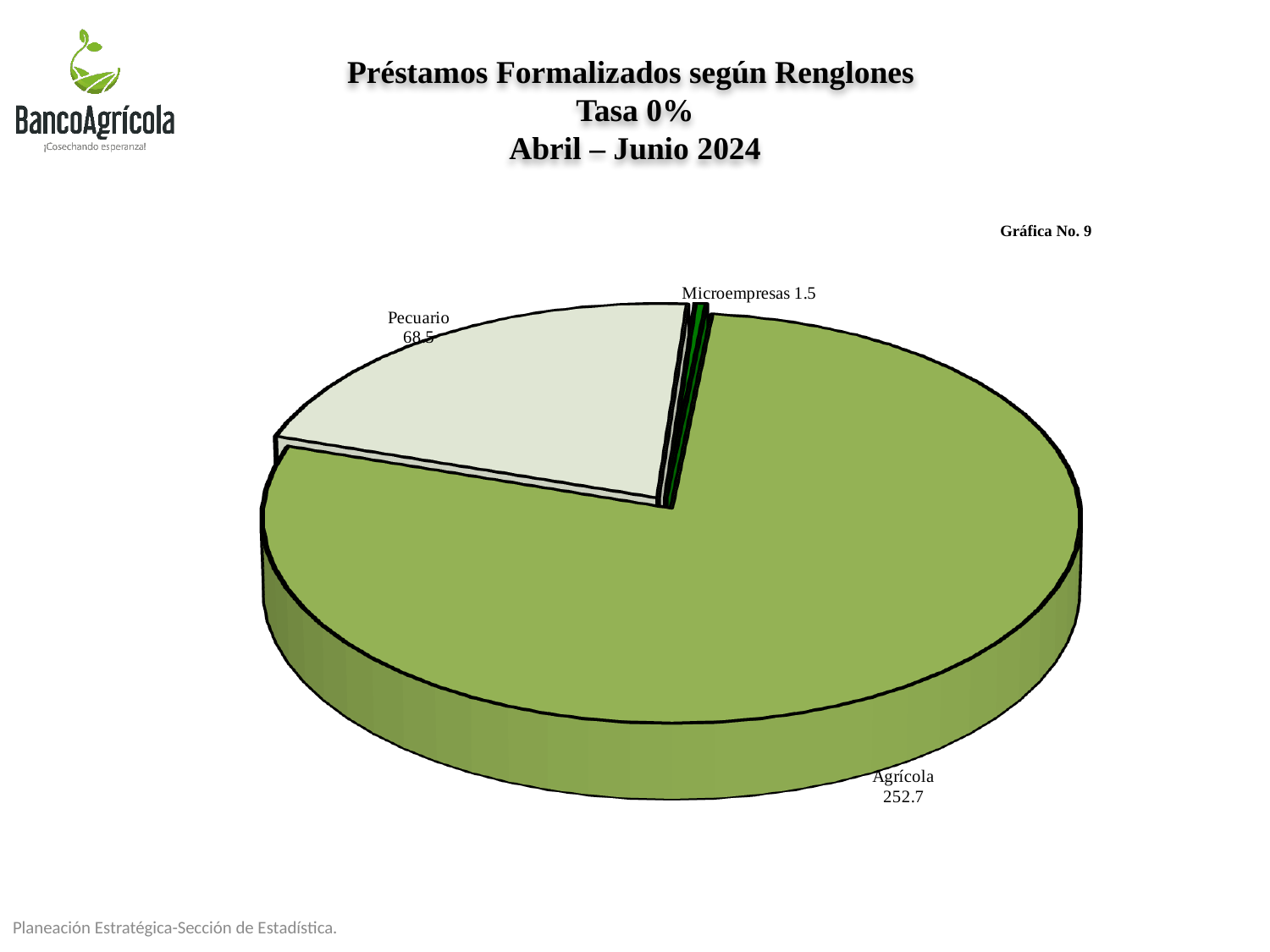
What period does the chart title say the data covers? Abril – Junio 2024 What is the difference between the values for Pecuario and Microempresas? 67.0 Which category has the largest slice of the pie? Agrícola What is the total of all the slices in the pie chart? 322.7 What is the difference between the values for Agrícola and Pecuario? 184.2 Which category has the smallest slice of the pie? Microempresas What type of chart is shown on the slide? Pie chart What is the value for Pecuario? 68.5 What is the value for Agrícola? 252.7 Which is larger, the value for Pecuario or the value for Microempresas? Pecuario How many categories are shown in the pie chart? 3 What is the value for Microempresas? 1.5